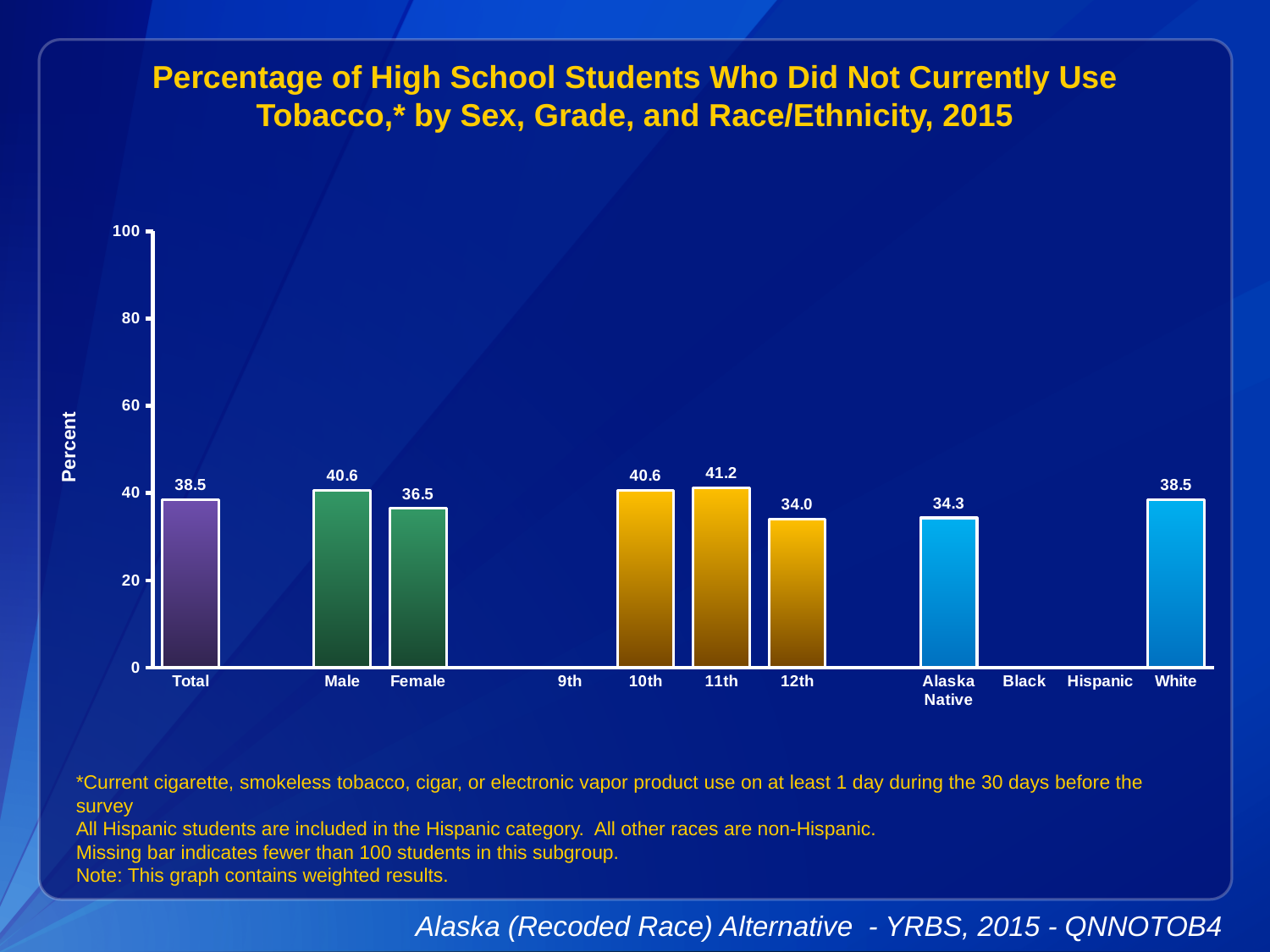
What is the value for Total? 38.5 What is the value for Alaska Native? 34.3 What is the difference between the Male and Female values? 4.1 What is the value for Female? 36.5 Which category with a bar has the lowest value? 12th How many categories on the x axis have no bar shown? 3 Is the value for White greater or less than 40? less Which is larger, the value for 10th grade or the value for 12th grade? 10th What is the label on the y axis? Percent What is the value for 12th grade? 34.0 What kind of chart is shown? bar chart Which category has the highest value? 11th